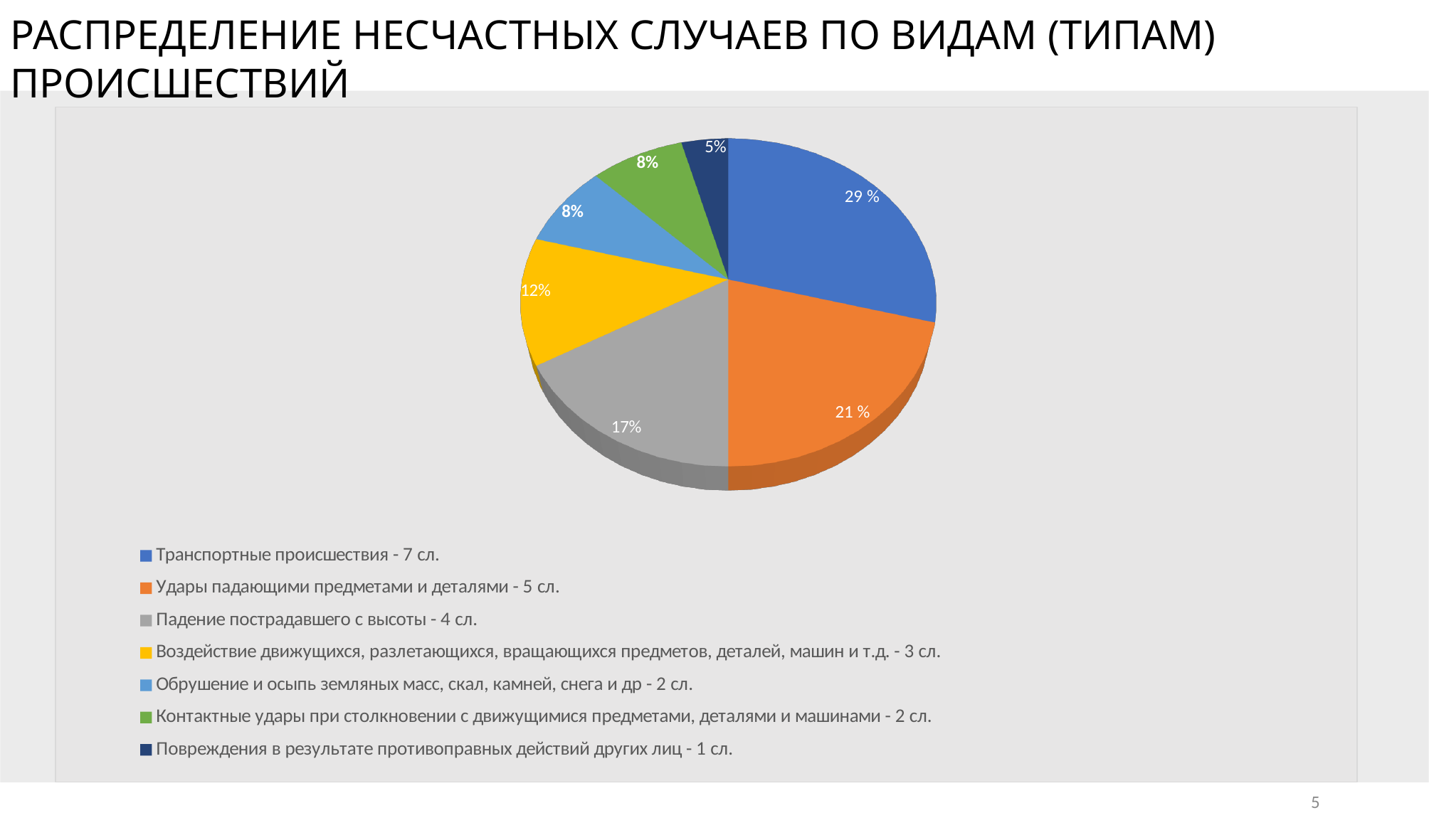
What percentage is shown for "Воздействие движущихся, разлетающихся, вращающихся предметов, деталей, машин и т.д. - 3 сл."? 12% What share of the pie does "Транспортные происшествия - 7 сл." take? 29 % What colour is the slice for "Удары падающими предметами и деталями - 5 сл."? Orange What kind of chart is shown on the slide? Pie chart What percentage is shown for "Падение пострадавшего с высоты - 4 сл."? 17% What is the difference in percentage points between "Транспортные происшествия" and "Удары падающими предметами и деталями"? 8 What percentage is shown for "Повреждения в результате противоправных действий других лиц - 1 сл."? 5% Which category has the largest slice of the pie? Транспортные происшествия - 7 сл. Which category has the smallest slice of the pie? Повреждения в результате противоправных действий других лиц - 1 сл. What share of the pie does "Удары падающими предметами и деталями - 5 сл." take? 21 % How many categories (slices) does the pie chart have? 7 Which is larger: the slice for "Падение пострадавшего с высоты" or the slice for "Воздействие движущихся, разлетающихся, вращающихся предметов, деталей, машин и т.д."? Падение пострадавшего с высоты